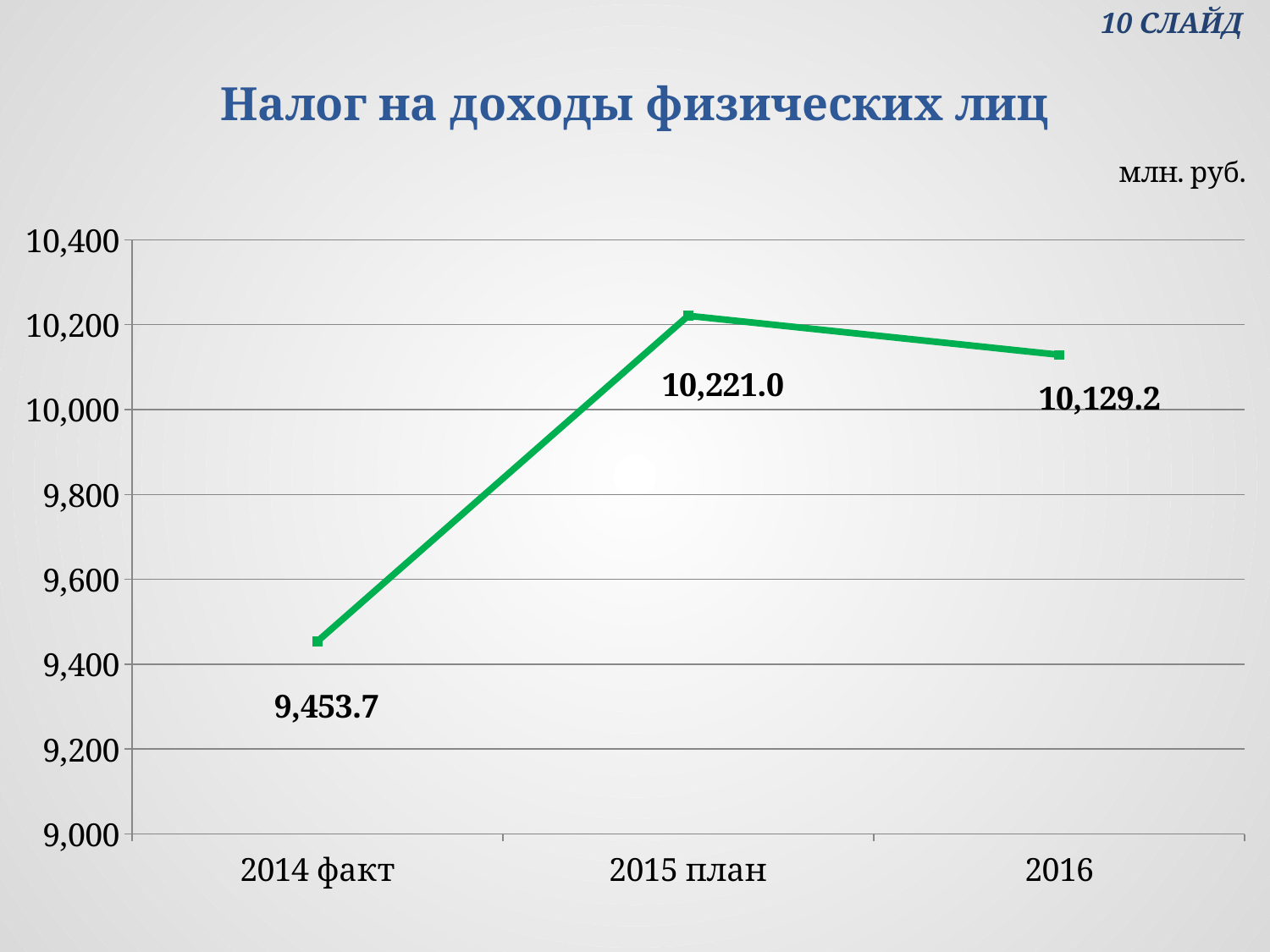
Which category has the lowest value? 2014 факт What is the value for 2015 план? 10,221.0 How many data points are plotted on the chart? 3 What is the difference between the values for 2015 план and 2016? 91.8 What kind of chart is shown on the slide? line chart Which is larger, the value for 2016 or the value for 2014 факт? 2016 What is the difference between the values for 2015 план and 2014 факт? 767.3 What is the value for 2014 факт? 9,453.7 Is the value for 2014 факт greater or less than 9,600? less Which category has the highest value? 2015 план What is the value for 2016? 10,129.2 What is the title of the chart? Налог на доходы физических лиц